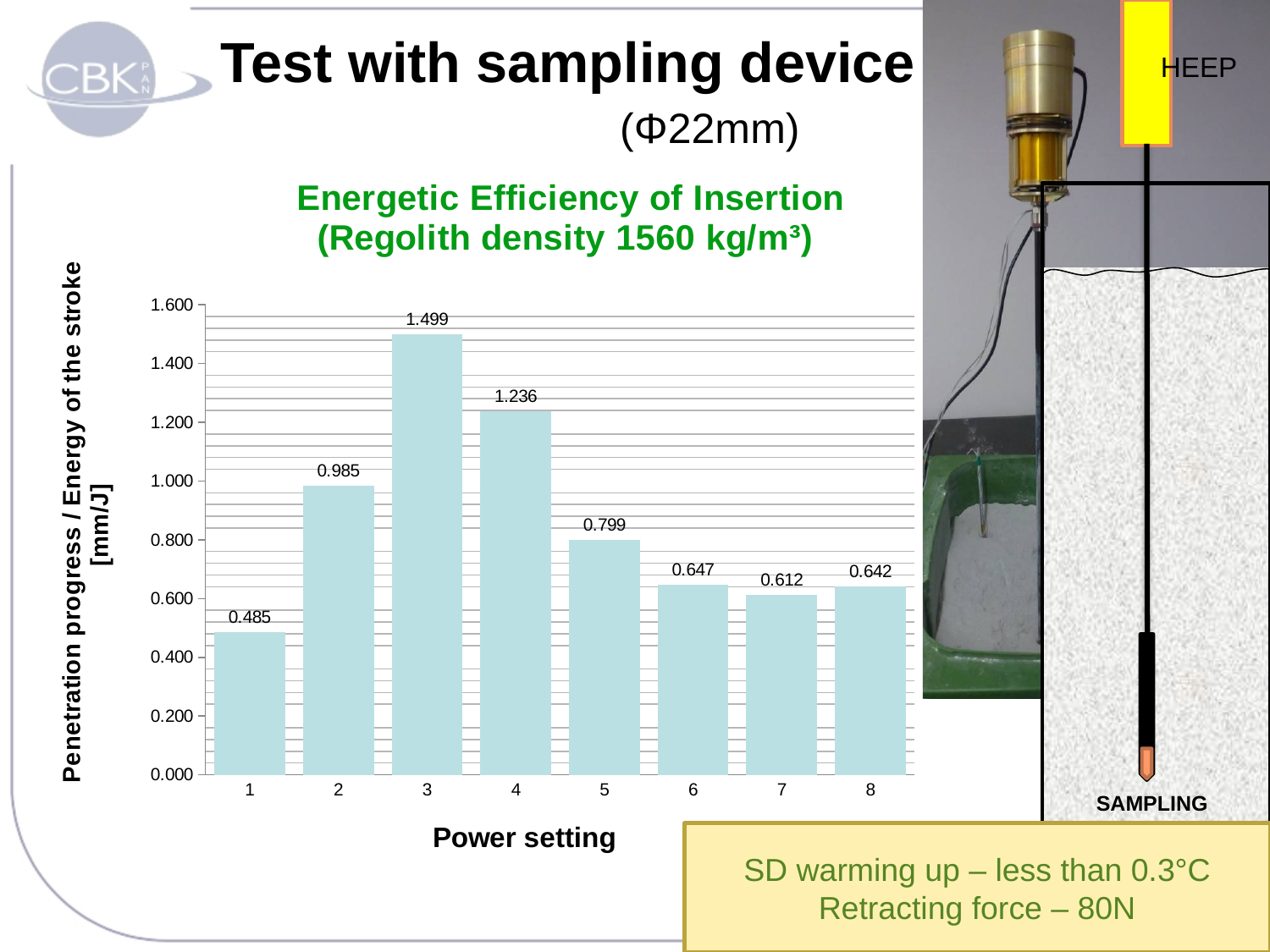
What is the value shown for power setting 7? 0.612 What is the difference between the values for power setting 3 and power setting 4? 0.263 What is the penetration progress per energy value for power setting 3? 1.499 What is the value shown for power setting 1? 0.485 Is the value for power setting 4 greater or less than 1.000? greater Which power setting has the lowest penetration progress per energy of the stroke? 1 What is the difference between the values for power setting 2 and power setting 1? 0.500 How many power settings are shown on the x axis? 8 Which has a larger value, power setting 5 or power setting 6? Power setting 5 What kind of chart is shown on the slide? Bar chart What is the unit given on the y axis of the chart? mm/J Which power setting has the highest penetration progress per energy of the stroke? 3